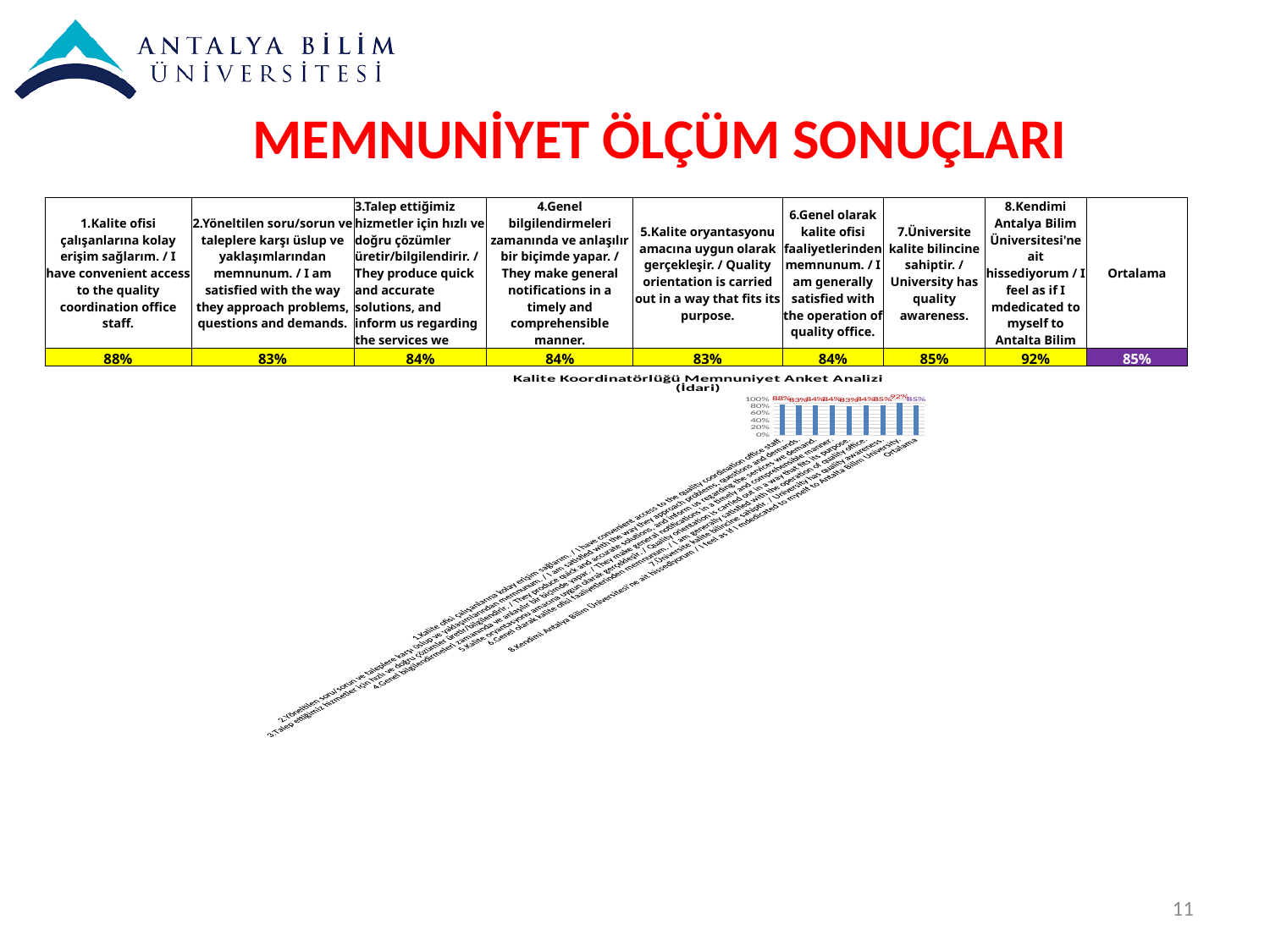
How many bars are plotted in the chart? 9 What is the difference between the highest bar (item 8) and the Ortalama bar? 7% What is the value of the bar for item 8 (Kendimi Antalya Bilim Üniversitesi'ne ait hissediyorum)? 92% What is the value of the bar for item 1 (Kalite ofisi çalışanlarına kolay erişim sağlarım)? 88% Which item has the highest bar in the chart? 8.Kendimi Antalya Bilim Üniversitesi'ne ait hissediyorum What kind of chart is shown on the slide? bar chart What is the title of the chart on the slide? Kalite Koordinatörlüğü Memnuniyet Anket Analizi (İdari) Which is larger, the bar for item 1 or the bar for item 7 (Üniversite kalite bilincine sahiptir)? item 1 What is the maximum value shown on the chart's vertical axis? 100% What is the value of the Ortalama bar in the chart? 85% Is the value of the bar for item 2 (Yöneltilen soru/sorun ve taleplere karşı üslup) greater or less than 60%? greater What is the difference between the bar for item 1 and the bar for item 5 (Kalite oryantasyonu amacına uygun olarak gerçekleşir)? 5%